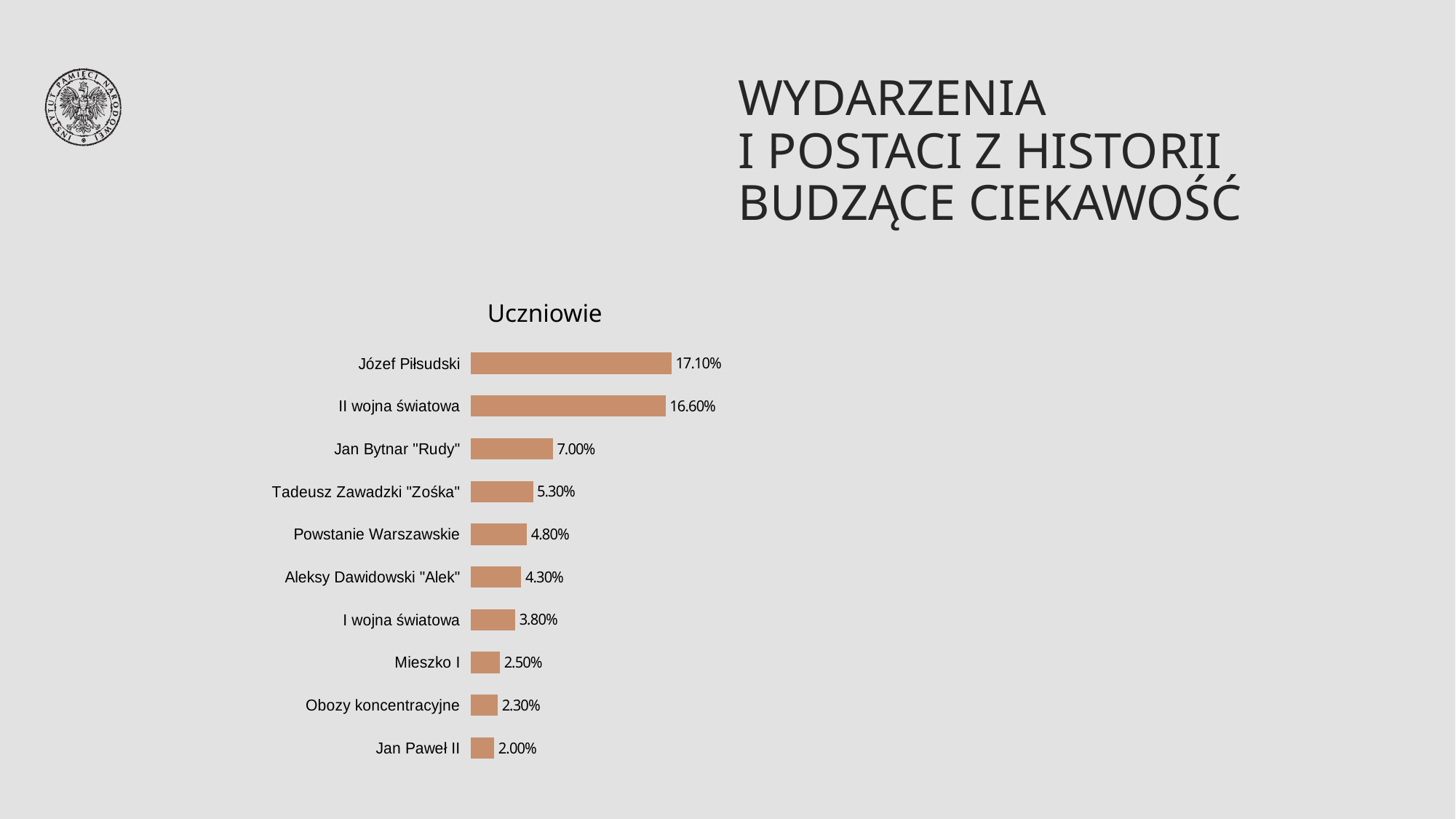
What kind of chart is shown on the slide? bar chart What is the difference between the values for Jan Bytnar "Rudy" and I wojna światowa? 3.20% What is the value for Obozy koncentracyjne? 2.30% Which category has the highest value? Józef Piłsudski Which is larger, the value for Tadeusz Zawadzki "Zośka" or the value for Aleksy Dawidowski "Alek"? Tadeusz Zawadzki "Zośka" How many categories are shown in the chart? 10 What is the title of the chart? Uczniowie What is the value for Mieszko I? 2.50% What is the value for Powstanie Warszawskie? 4.80% What is the difference between the values for Józef Piłsudski and II wojna światowa? 0.50% What is the value for Józef Piłsudski? 17.10% Which category has the lowest value? Jan Paweł II